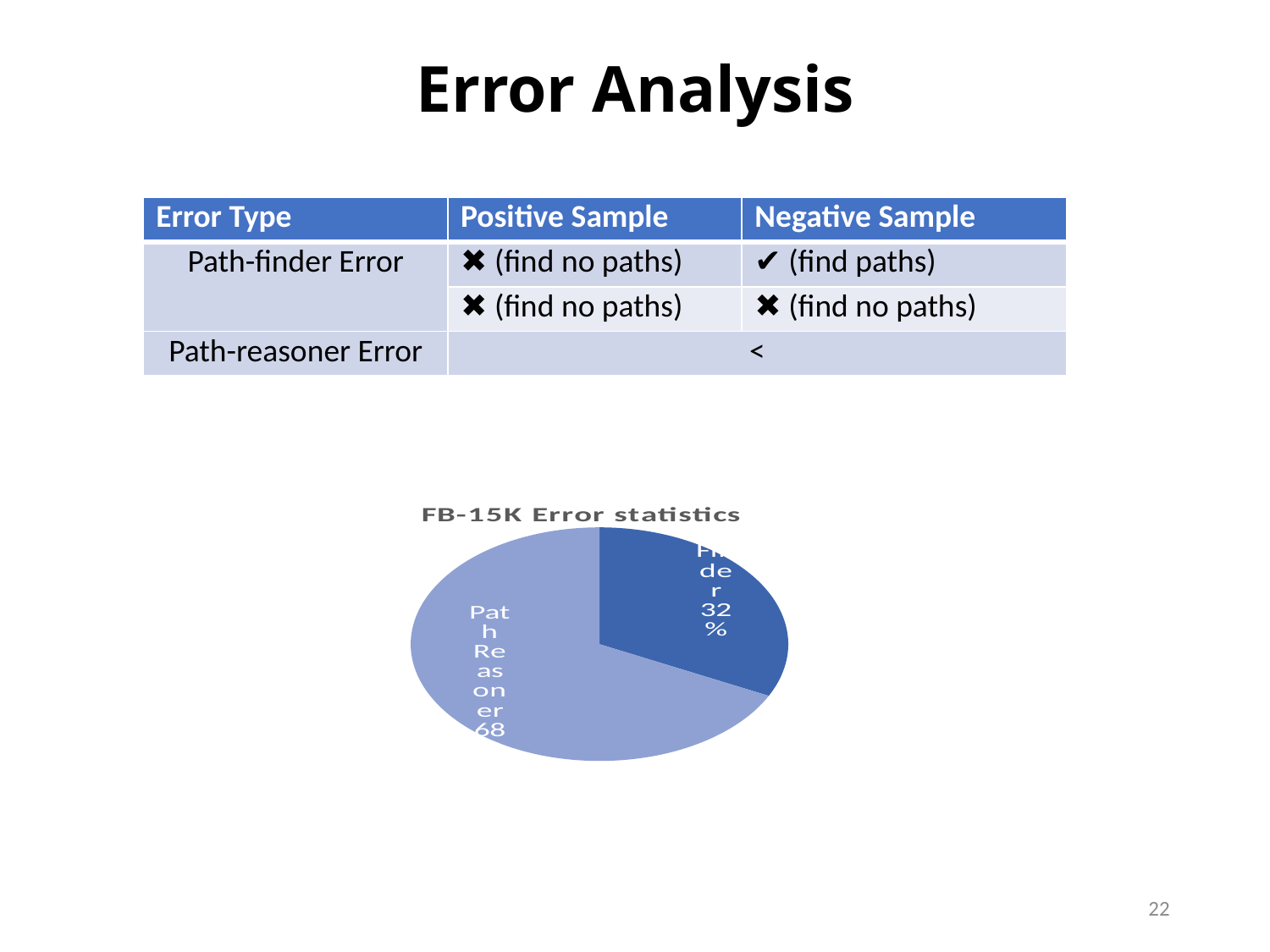
In the FB-15K Error statistics pie chart, which error type accounts for the smallest share? Path Finder In the FB-15K Error statistics pie chart, which slice is larger, Path Finder or Path Reasoner? Path Reasoner What is the title of the chart on the slide? FB-15K Error statistics How many slices does the FB-15K Error statistics pie chart have? 2 What kind of chart is shown on the slide? pie chart In the FB-15K Error statistics pie chart, which slice is drawn in the darker blue colour? Path Finder In the FB-15K Error statistics pie chart, is the Path Finder share greater or less than 50%? less In the FB-15K Error statistics pie chart, what share is labelled for the Path Finder slice? 32% In the FB-15K Error statistics pie chart, is the Path Reasoner share greater or less than 50%? greater In the FB-15K Error statistics pie chart, which error type accounts for the largest share? Path Reasoner